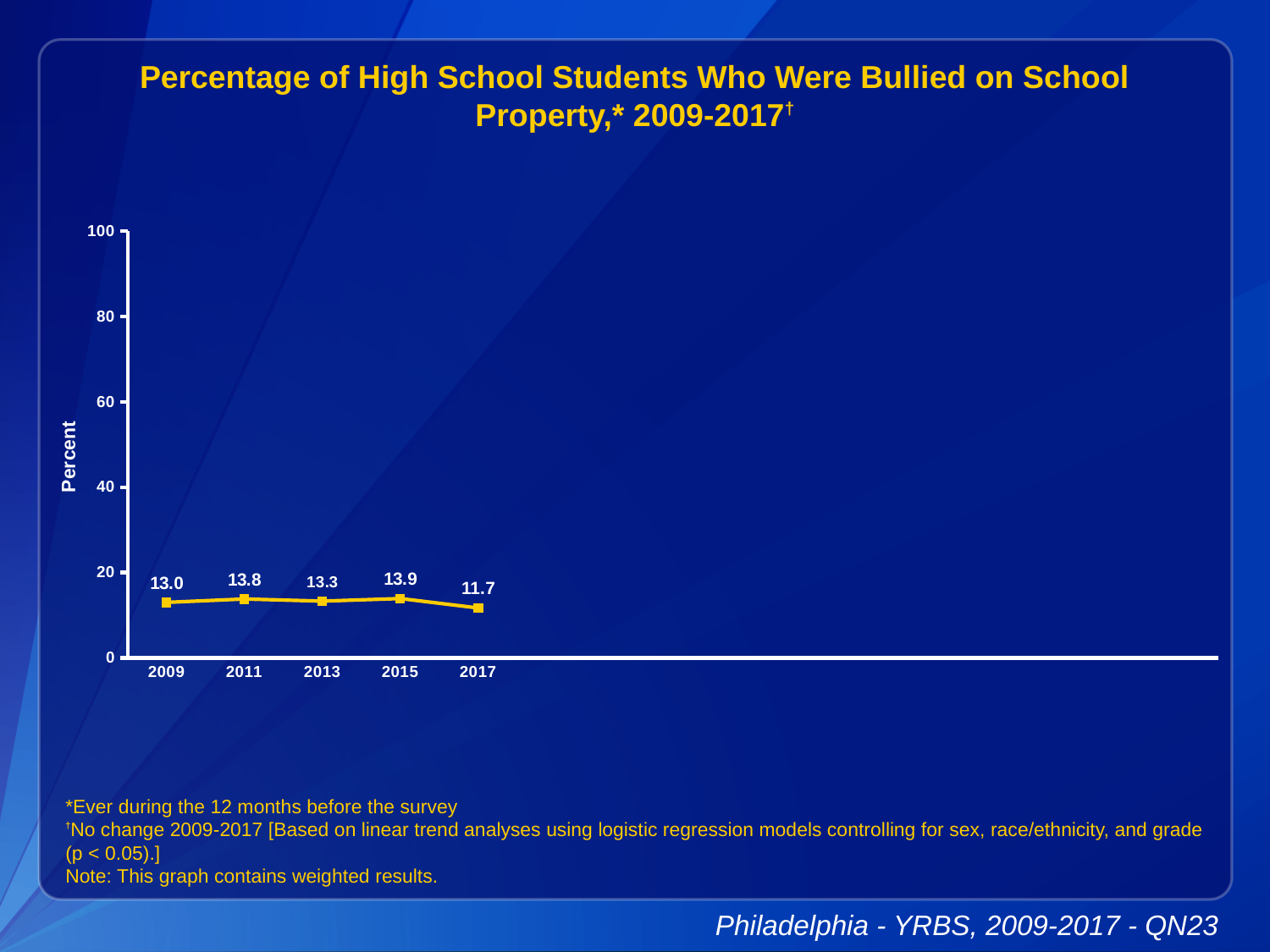
What is the value plotted for 2017? 11.7 What is the value plotted for 2013? 13.3 What percentage of high school students were bullied on school property in 2009? 13.0 Is the value for 2011 greater or less than 20? less What is the maximum value shown on the vertical axis? 100 How many years are plotted on the chart? 5 What is the difference between the 2015 value and the 2017 value? 2.2 Which year has the highest percentage of students bullied on school property? 2015 What kind of chart is shown on the slide? line chart Which year has a larger value, 2011 or 2013? 2011 Which year has the lowest percentage of students bullied on school property? 2017 What is the label on the vertical axis? Percent